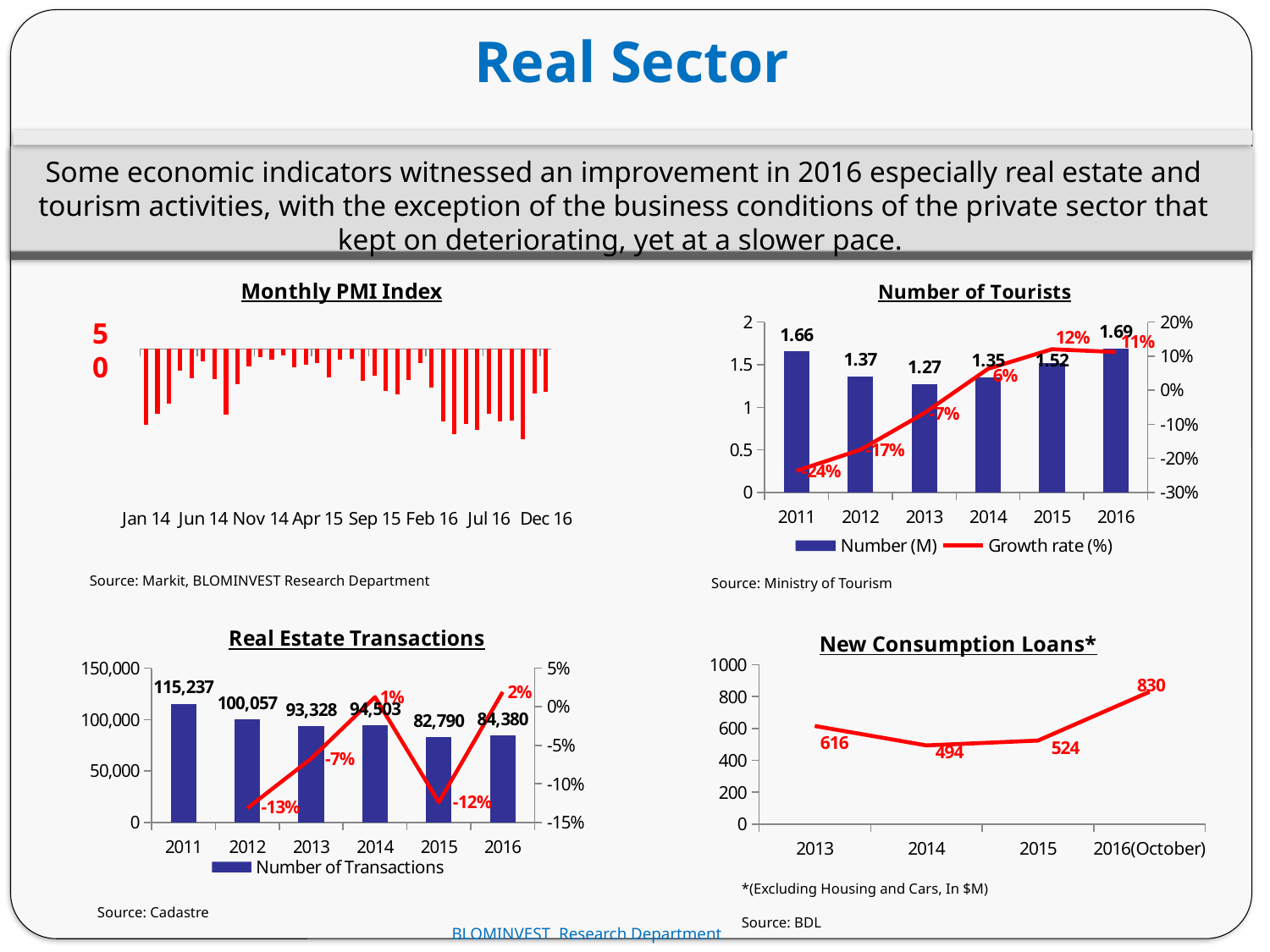
In the Real Estate Transactions chart, which year has the highest number of transactions? 2011 In the Number of Tourists chart, what is the growth rate shown for 2011? -24% In the Number of Tourists chart, how many series does the legend list? 2 In the Real Estate Transactions chart, what is the difference in number of transactions between 2011 and 2012? 15,180 In the New Consumption Loans chart, what is the value for 2014? 494 In the Real Estate Transactions chart, what is the growth rate shown for 2015? -12% In the New Consumption Loans chart, which year has the highest value? 2016(October) In the Number of Tourists chart, what is the number of tourists (M) for 2016? 1.69 In the New Consumption Loans chart, how many data points are plotted? 4 What kind of chart is the Monthly PMI Index chart? bar chart In the Number of Tourists chart, which year has the lowest number of tourists? 2013 In the Real Estate Transactions chart, what is the number of transactions for 2015? 82,790